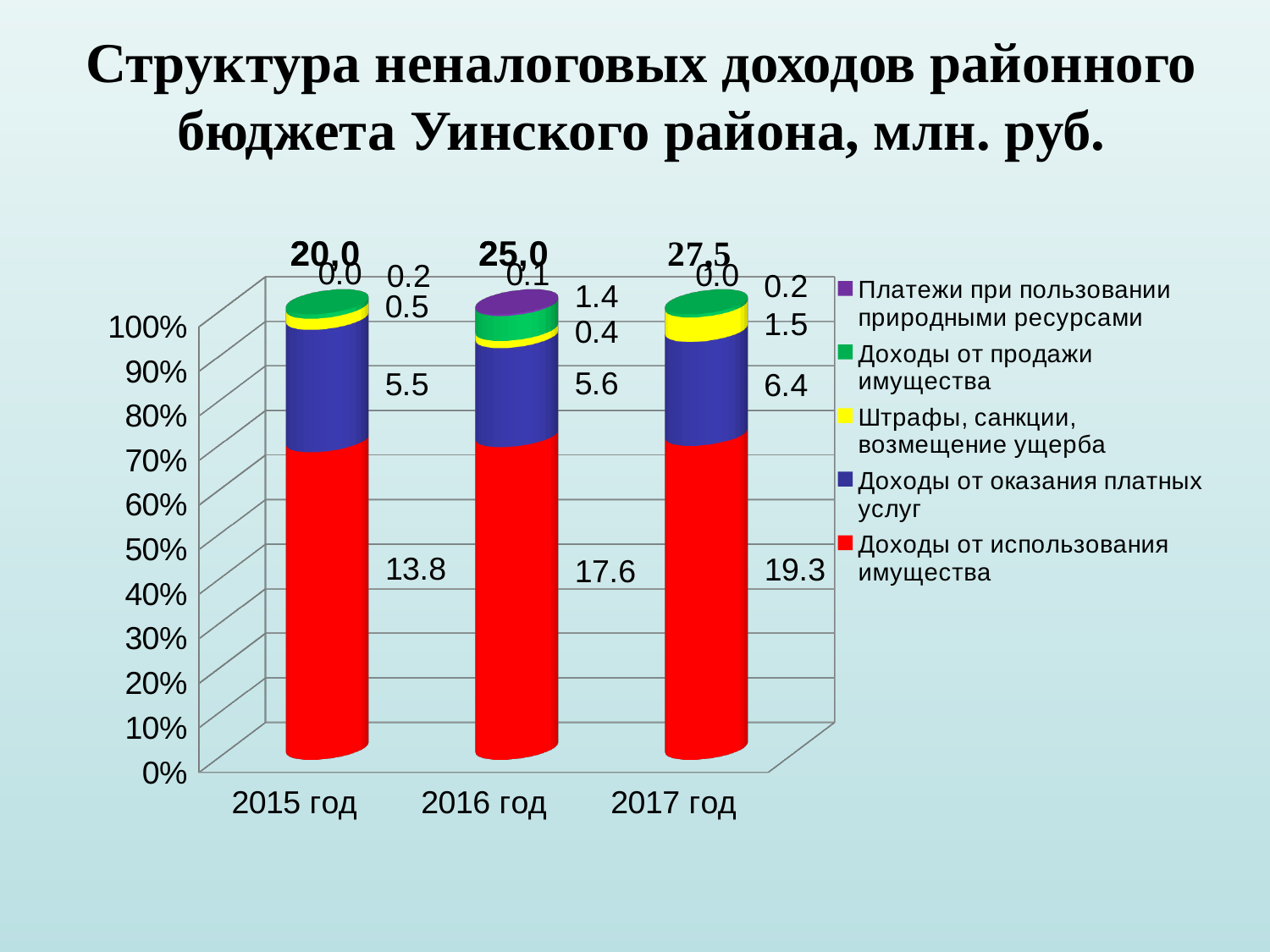
What kind of chart is shown on the slide? Stacked bar chart How many years are shown on the x axis? 3 What is the value of Доходы от оказания платных услуг for 2015 год? 5.5 How many series does the legend list? 5 What is the value of Доходы от продажи имущества for 2016 год? 1.4 What is the total shown above the bar for 2016 год? 25.0 What is the difference in Доходы от использования имущества between 2017 год and 2015 год? 5.5 Which year has the highest value for Доходы от использования имущества? 2017 год What is the value of Штрафы, санкции, возмещение ущерба for 2017 год? 1.5 What is the value of Доходы от использования имущества for 2017 год? 19.3 Which is larger: Доходы от оказания платных услуг in 2016 год or in 2017 год? 2017 год Which year has the lowest total non-tax revenue? 2015 год